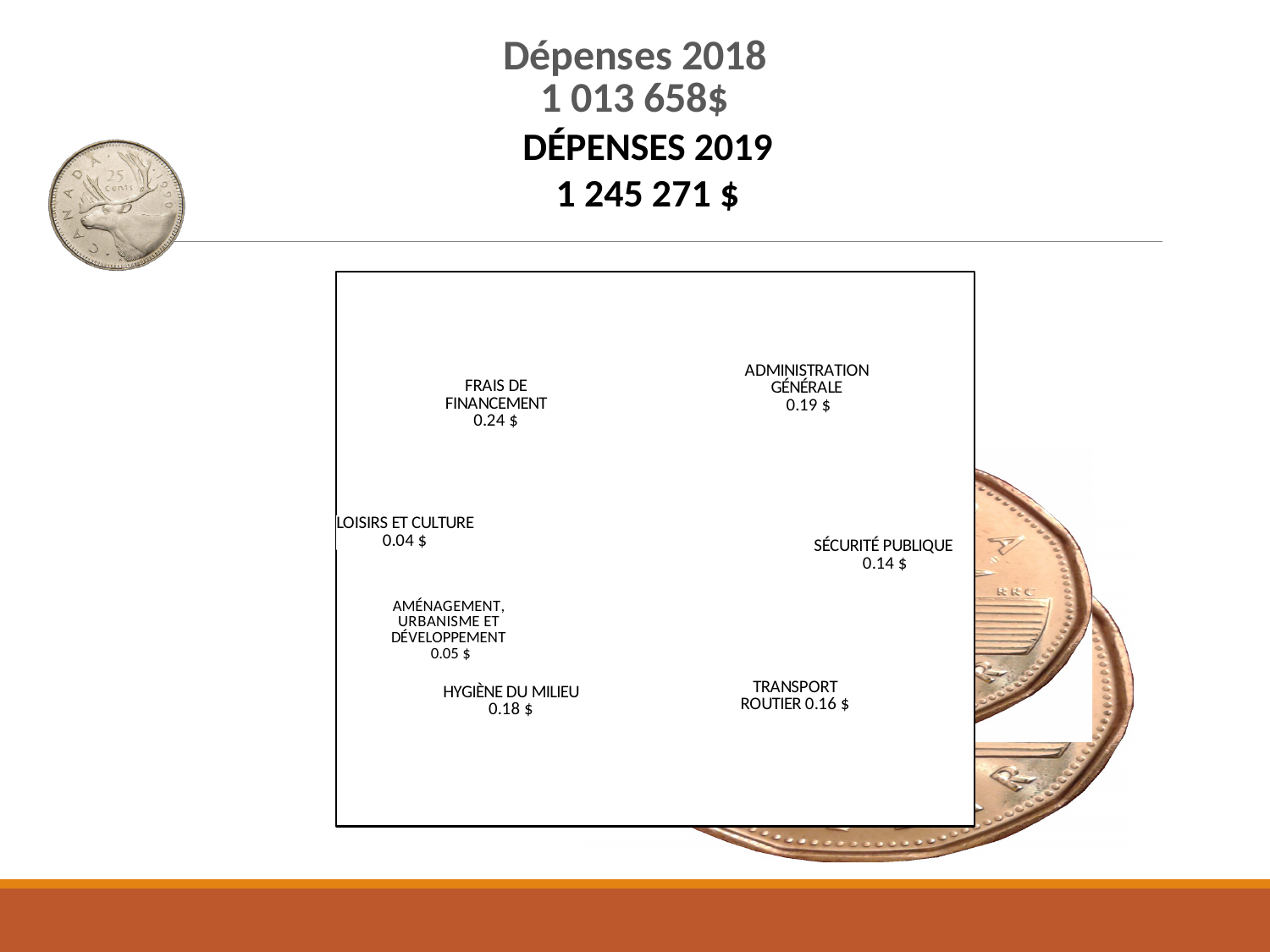
What is the value shown for SÉCURITÉ PUBLIQUE? 0.14 $ What is the difference between the values for FRAIS DE FINANCEMENT and ADMINISTRATION GÉNÉRALE? 0.05 $ How many categories are labelled on the chart? 7 What is the value shown for HYGIÈNE DU MILIEU? 0.18 $ Which category has the lowest value on the chart? LOISIRS ET CULTURE What is the value shown for FRAIS DE FINANCEMENT? 0.24 $ Which is larger, the value for SÉCURITÉ PUBLIQUE or the value for TRANSPORT ROUTIER? TRANSPORT ROUTIER What is the value shown for TRANSPORT ROUTIER? 0.16 $ Which category has the highest value on the chart? FRAIS DE FINANCEMENT What total amount of expenses for 2019 is shown in the slide title? 1 245 271 $ What is the difference between the values for HYGIÈNE DU MILIEU and LOISIRS ET CULTURE? 0.14 $ What is the value shown for ADMINISTRATION GÉNÉRALE? 0.19 $